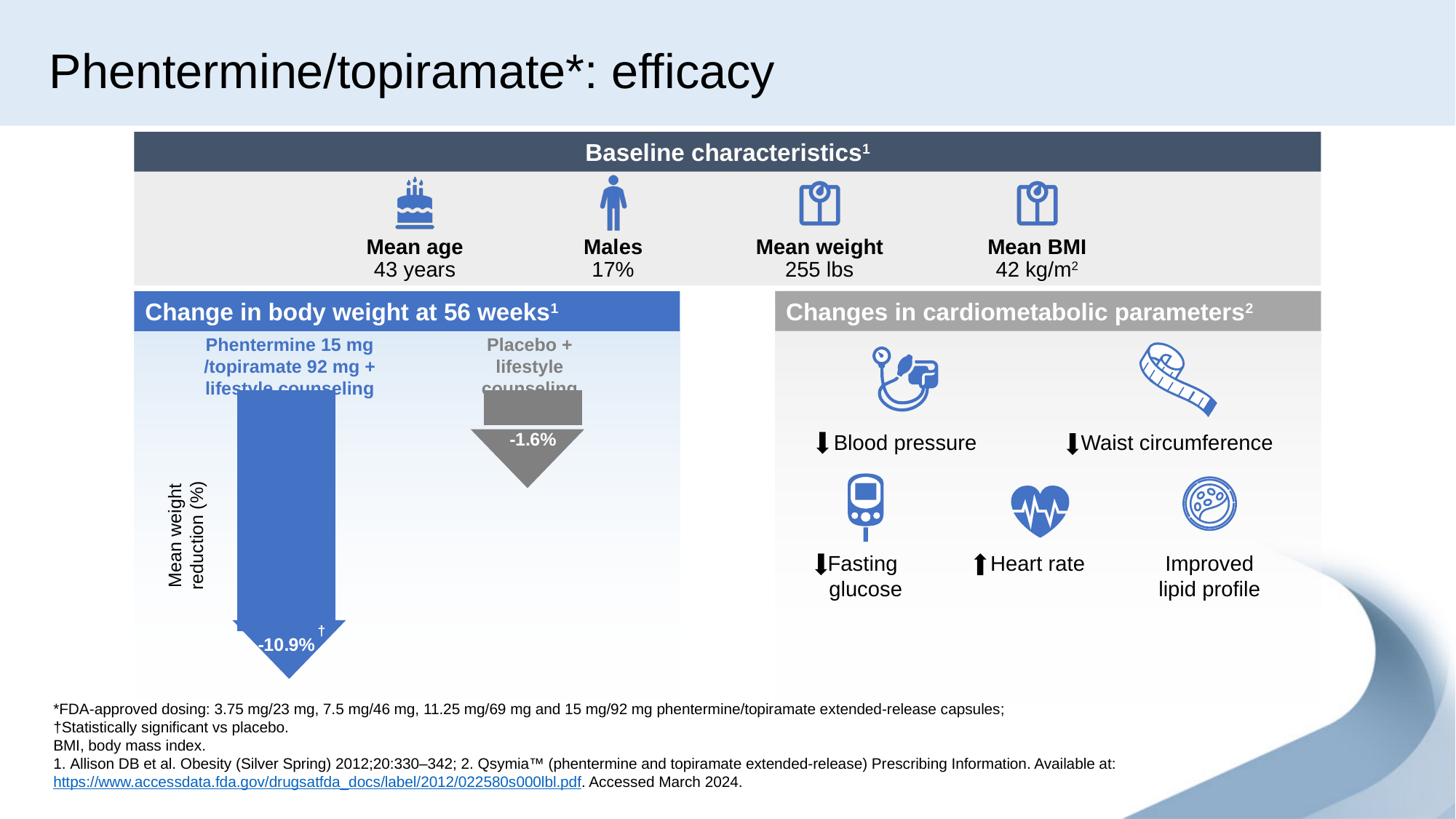
What is the y-axis label of the 'Change in body weight at 56 weeks' chart? Mean weight reduction (%) In the 'Change in body weight at 56 weeks' chart, which group's result is marked as statistically significant vs placebo? Phentermine 15 mg/topiramate 92 mg + lifestyle counseling What kind of chart is used to show the change in body weight at 56 weeks? Bar chart In the 'Change in body weight at 56 weeks' chart, what is the mean weight reduction for phentermine 15 mg/topiramate 92 mg + lifestyle counseling? -10.9% In the 'Change in body weight at 56 weeks' chart, which group shows the larger mean weight reduction? Phentermine 15 mg/topiramate 92 mg + lifestyle counseling In the 'Change in body weight at 56 weeks' chart, what is the mean weight reduction for placebo + lifestyle counseling? -1.6% How many groups are plotted in the 'Change in body weight at 56 weeks' chart? 2 In the 'Change in body weight at 56 weeks' chart, what is the difference in mean weight reduction between the phentermine/topiramate group and the placebo group? 9.3 percentage points In the 'Change in body weight at 56 weeks' chart, is the weight reduction greater for the phentermine/topiramate group or the placebo group? Phentermine/topiramate group In the 'Change in body weight at 56 weeks' chart, which group shows the smaller mean weight reduction? Placebo + lifestyle counseling